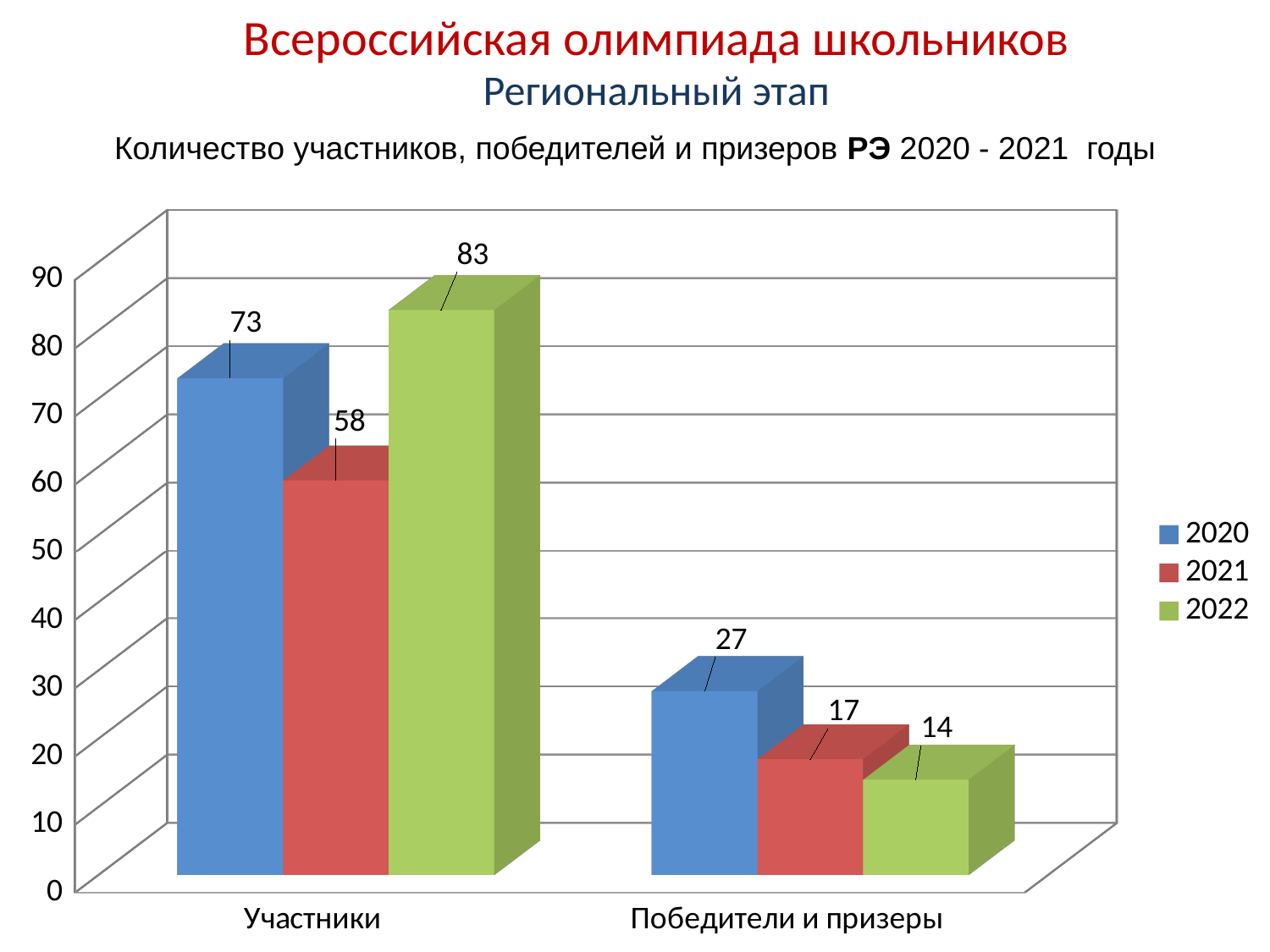
Which colour represents the 2021 series? red What is the difference between the 2020 and 2021 values for Победители и призеры? 10 What is the value for Победители и призеры in the 2022 series? 14 Which series has the highest value for Участники? 2022 What kind of chart is shown on the slide? bar chart What is the value for Участники in the 2020 series? 73 Which series has the lowest value for Победители и призеры? 2022 What is the value for Участники in the 2021 series? 58 How many categories are shown on the x axis? 2 Which is larger: the 2020 value for Участники or the 2021 value for Участники? 2020 How many series does the legend list? 3 What is the difference between the 2022 and 2020 values for Участники? 10